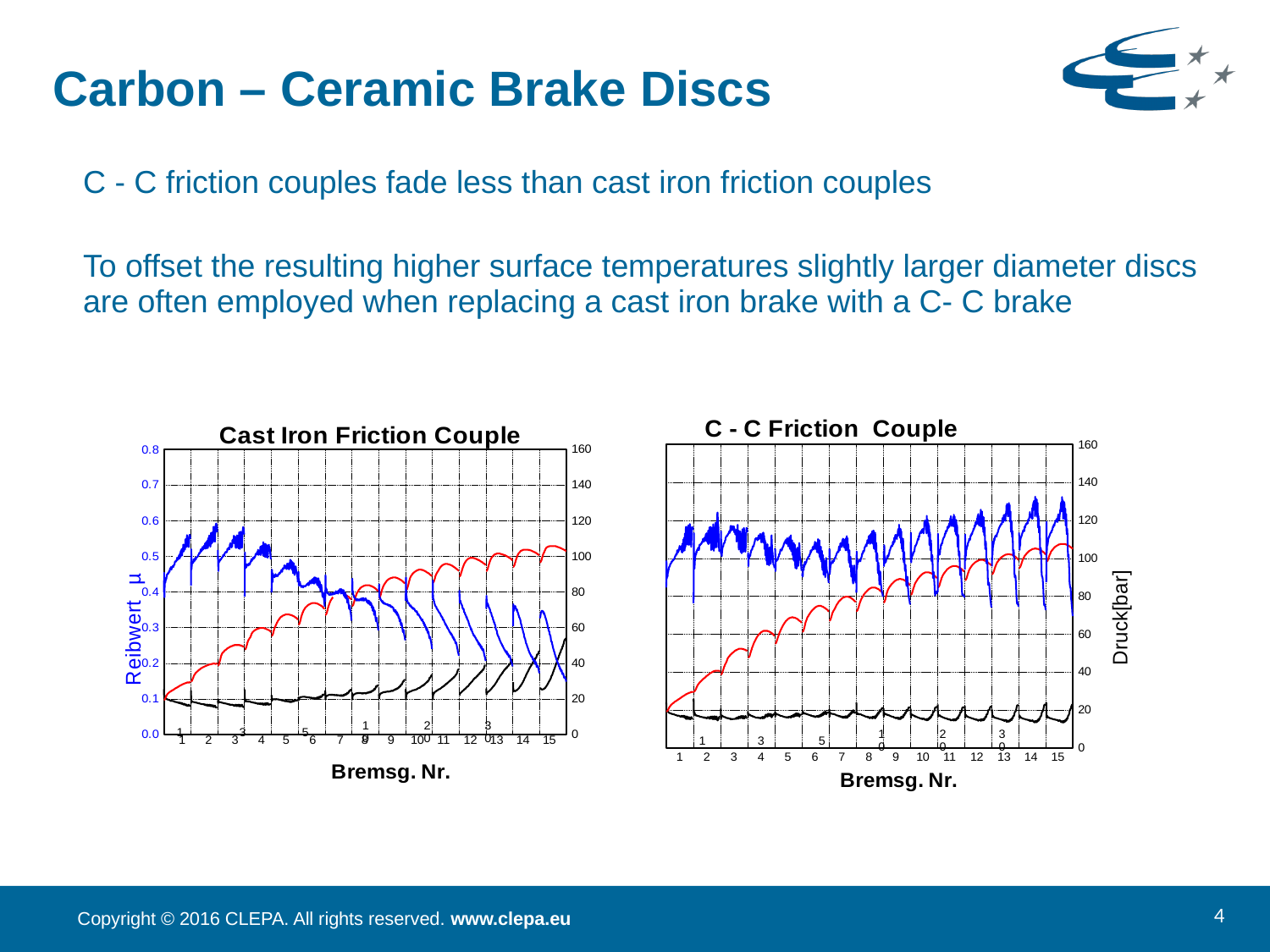
In the "Cast Iron Friction Couple" chart, does the red line rise or fall as the braking number increases? Rise In the "Cast Iron Friction Couple" chart, how many braking numbers (Bremsg. Nr.) are marked on the x axis? 15 What kind of chart is the "Cast Iron Friction Couple" chart? Line chart In the "C - C Friction Couple" chart, is the black line at braking number 15 greater or less than 40 on the right axis? less In the "C - C Friction Couple" chart, does the red line rise or fall as the braking number increases? Rise In the "Cast Iron Friction Couple" chart, does the blue line rise or fall as the braking number increases? Fall In the "C - C Friction Couple" chart, is the red line at braking number 1 greater or less than 60 on the right axis? less What is the x-axis label of the "Cast Iron Friction Couple" chart? Bremsg. Nr. What kind of chart is the "C - C Friction Couple" chart? Line chart In the "Cast Iron Friction Couple" chart, is the red line at braking number 15 greater or less than 80 on the right axis? greater In the "C - C Friction Couple" chart, how many braking numbers (Bremsg. Nr.) are marked on the x axis? 15 What is the label of the right-hand y axis of the "C - C Friction Couple" chart? Druck[bar]